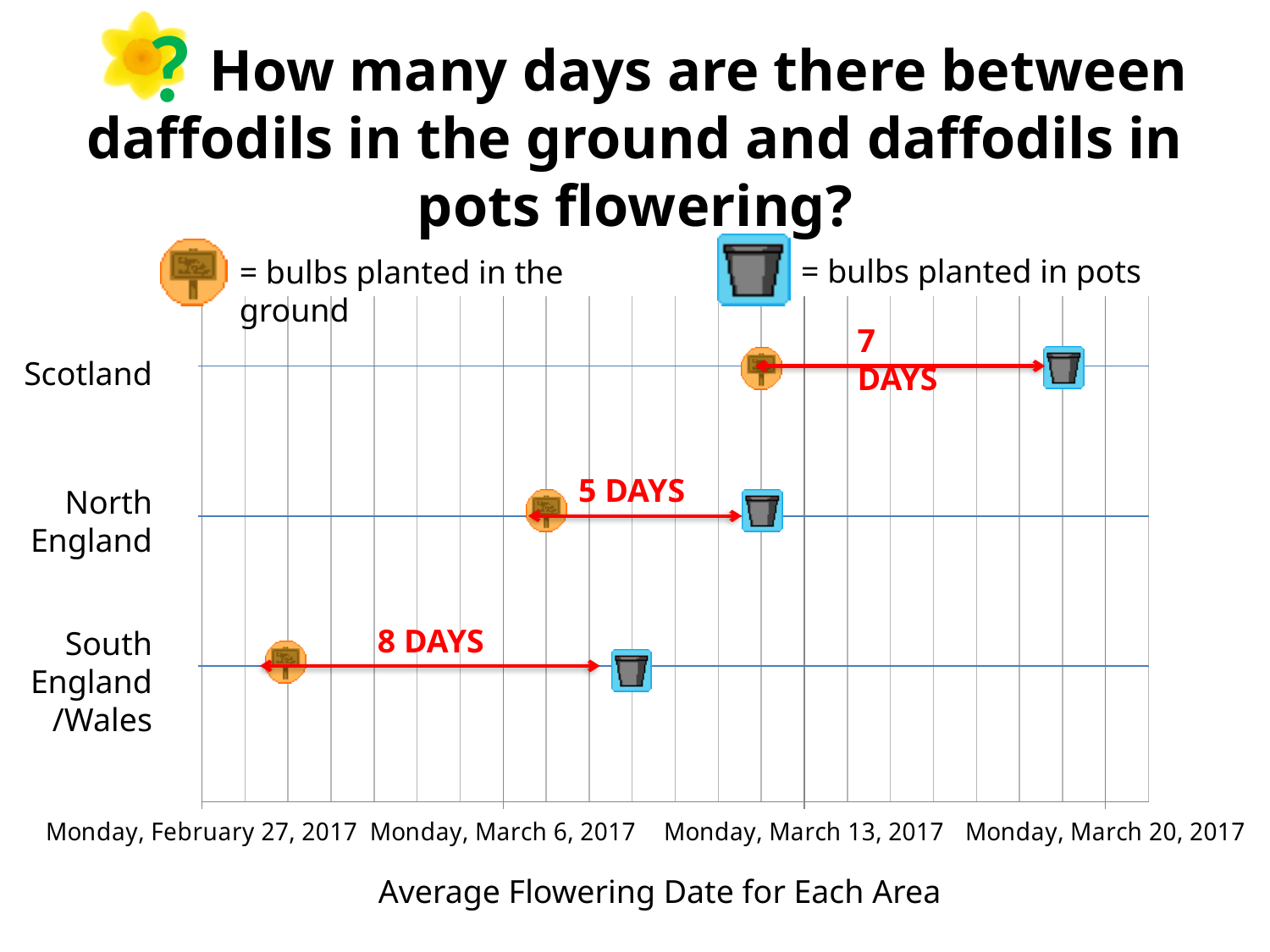
Is the flowering gap larger for Scotland or for North England? Scotland How many days are there between ground and pot daffodils flowering in South England/Wales? 8 DAYS Is the average flowering date for bulbs planted in pots in Scotland earlier or later than Monday, March 13, 2017? later How many days are there between ground and pot daffodils flowering in Scotland? 7 DAYS How many days larger is the flowering gap for South England/Wales than for North England? 3 days Is the average flowering date for bulbs planted in the ground in South England/Wales earlier or later than Monday, March 6, 2017? earlier How many days are there between ground and pot daffodils flowering in North England? 5 DAYS Which area has the smallest gap in days between ground and pot daffodils flowering? North England Which area has the largest gap in days between ground and pot daffodils flowering? South England/Wales How many series does the legend list? 2 How many areas are shown on the chart? 3 What is the title of the horizontal axis? Average Flowering Date for Each Area